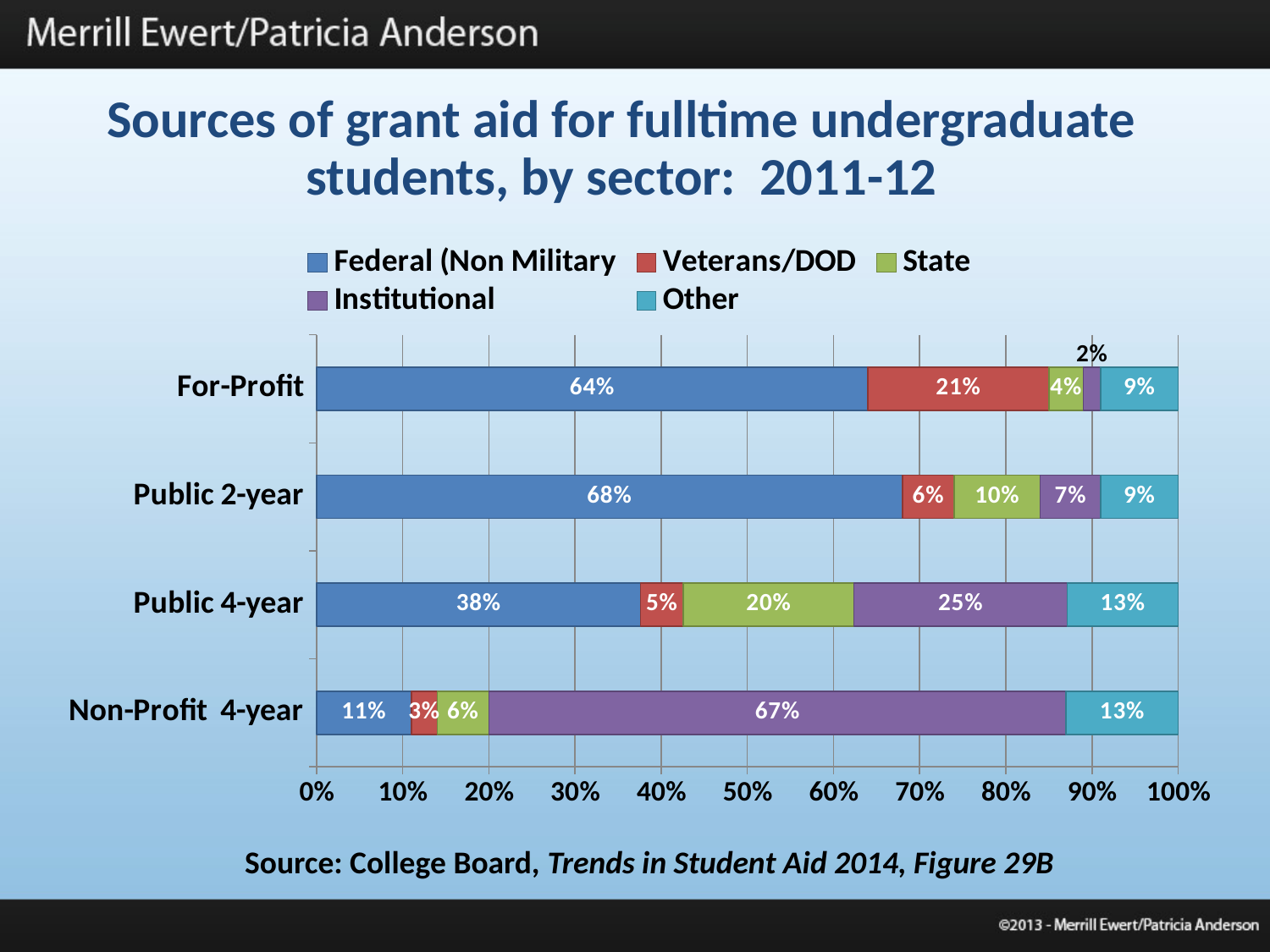
What is the Institutional share of grant aid for Non-Profit 4-year students? 67% Which sector has the highest Federal (Non Military) share of grant aid? Public 2-year What kind of chart is shown on the slide? Stacked bar chart What is the Veterans/DOD share of grant aid for For-Profit students? 21% How many sectors are shown on the chart? 4 Which colour represents the Other series in the chart? Teal Which is larger: the State share for Public 2-year or the State share for Public 4-year? Public 4-year What is the difference between the Institutional share for Non-Profit 4-year and for Public 4-year? 42% Which sector has the lowest Institutional share of grant aid? For-Profit What is the State share of grant aid for Public 4-year students? 20% What share of grant aid for Public 2-year students comes from Federal (Non Military) sources? 68% How many series does the legend list? 5